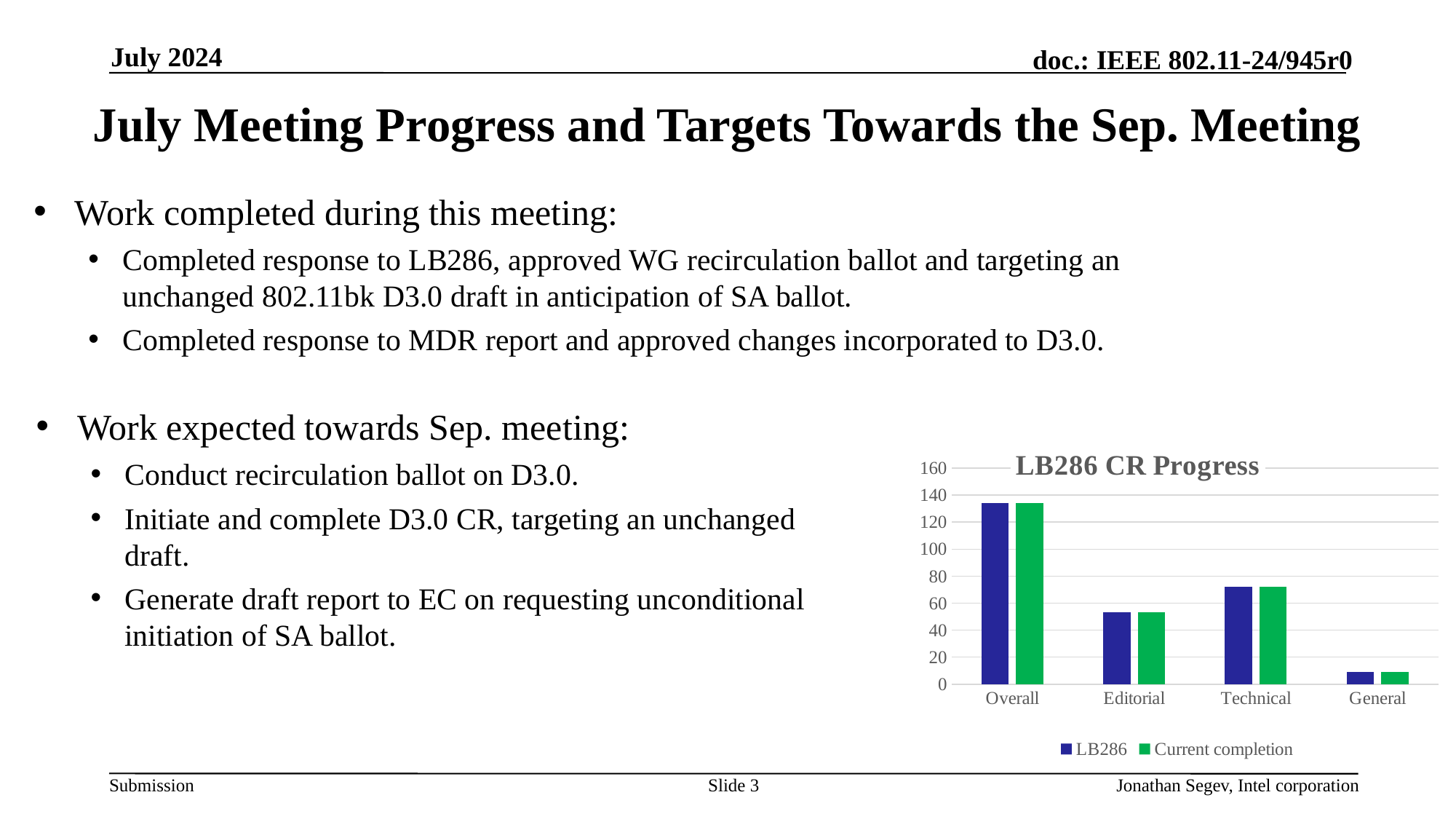
What are the two series named in the chart's legend? LB286 and Current completion Is the Current completion value for Technical greater or less than 60? greater Which category has the highest value in the chart? Overall What kind of chart is shown on the slide? bar chart Is the LB286 value for Overall greater or less than 120? greater Is the LB286 value for Editorial greater or less than 60? less Which is larger, the LB286 value for Technical or the LB286 value for Editorial? Technical Which category has the lowest value in the chart? General How many series does the chart's legend list? 2 What is the title of the chart on the slide? LB286 CR Progress How many categories are shown on the x axis of the chart? 4